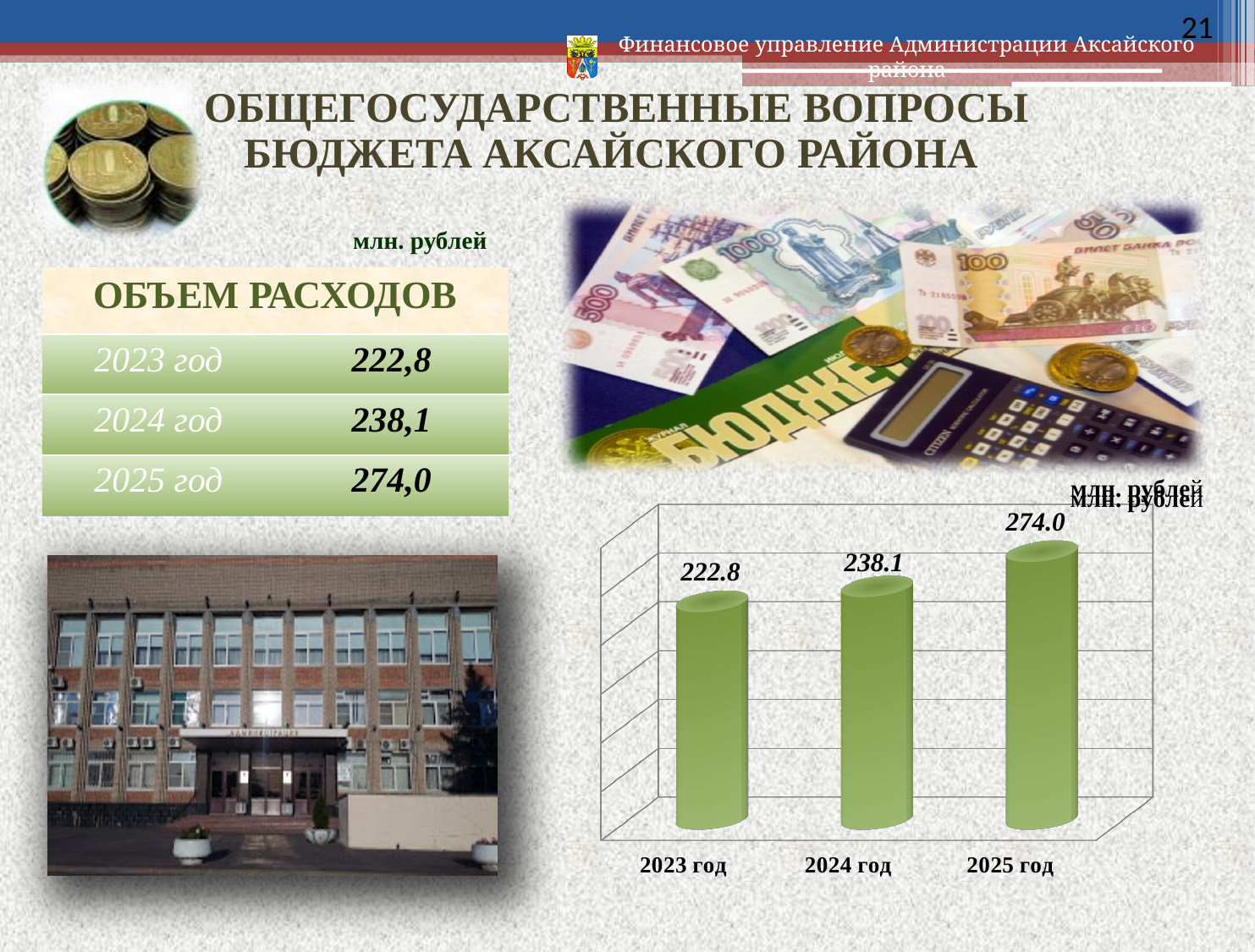
What unit is indicated above the chart? млн. рублей Which year has the lowest value in the chart? 2023 год Which year has the highest value in the chart? 2025 год What is the value for 2023 год in the chart? 222.8 Which is larger in the chart, the value for 2024 год or the value for 2025 год? 2025 год What is the value for 2025 год in the chart? 274.0 What type of chart is shown on the slide? bar chart What is the difference between the values for 2025 год and 2023 год in the chart? 51.2 What is the value for 2024 год in the chart? 238.1 What is the difference between the values for 2024 год and 2023 год in the chart? 15.3 Do the values in the chart rise or fall from 2023 год to 2025 год? rise How many bars are shown in the chart? 3